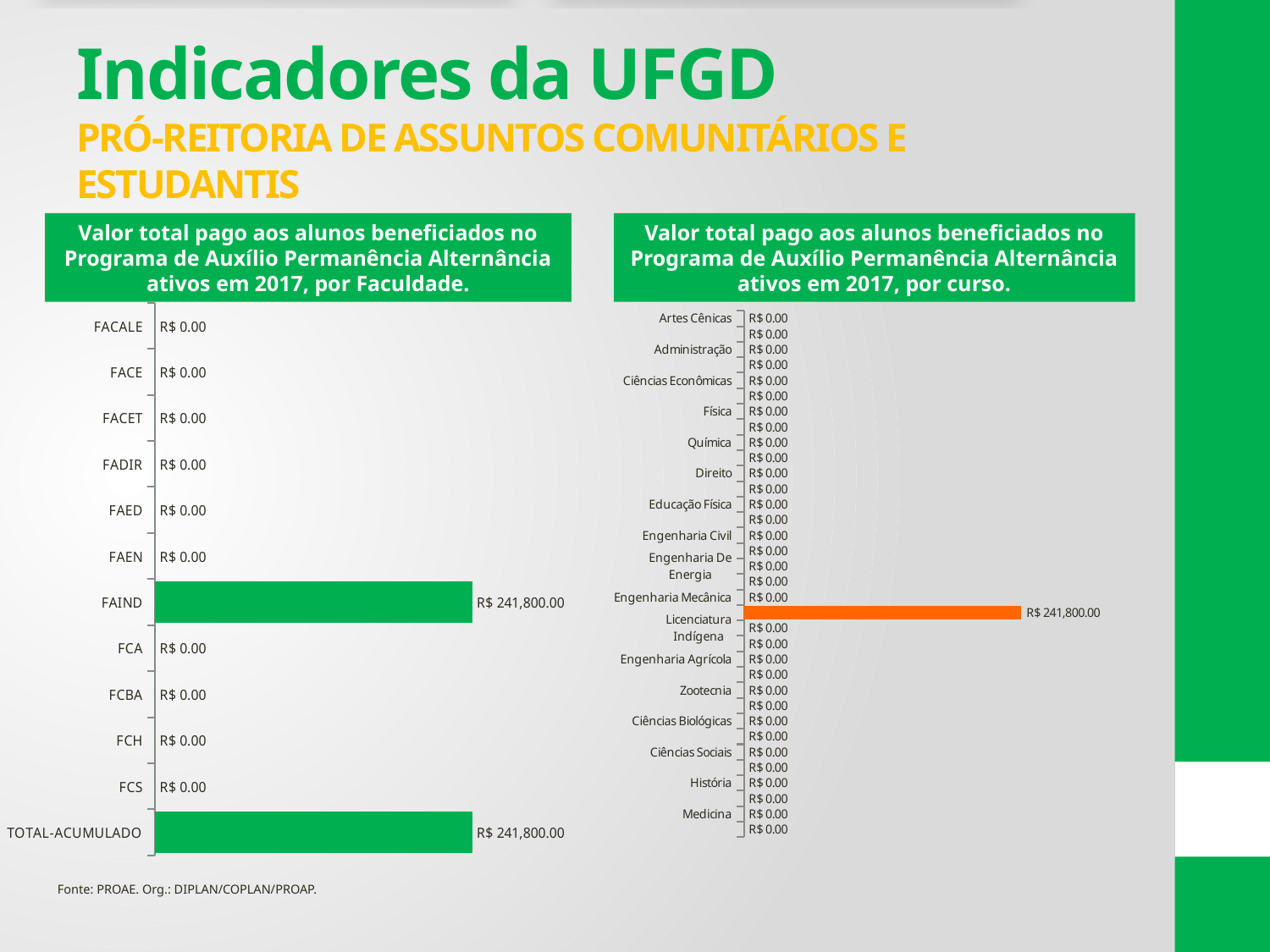
In the left chart (por Faculdade), what is the value for TOTAL-ACUMULADO? R$ 241,800.00 In the left chart (por Faculdade), which is larger, the value for FAIND or the value for FCS? FAIND In the left chart (por Faculdade), what is the difference between the values for FAIND and FCH? R$ 241,800.00 In the left chart (por Faculdade), which faculty (excluding the total) has the highest value? FAIND In the right chart (por curso), what is the value for Medicina? R$ 0.00 In the left chart (por Faculdade), how many categories are listed on the axis, including TOTAL-ACUMULADO? 12 In the right chart (por curso), what is the value for Licenciatura Indígena? R$ 0.00 What type of chart is the left chart (por Faculdade)? Bar chart In the left chart (por Faculdade), what is the value for FACALE? R$ 0.00 In the left chart (por Faculdade), what is the value for FAIND? R$ 241,800.00